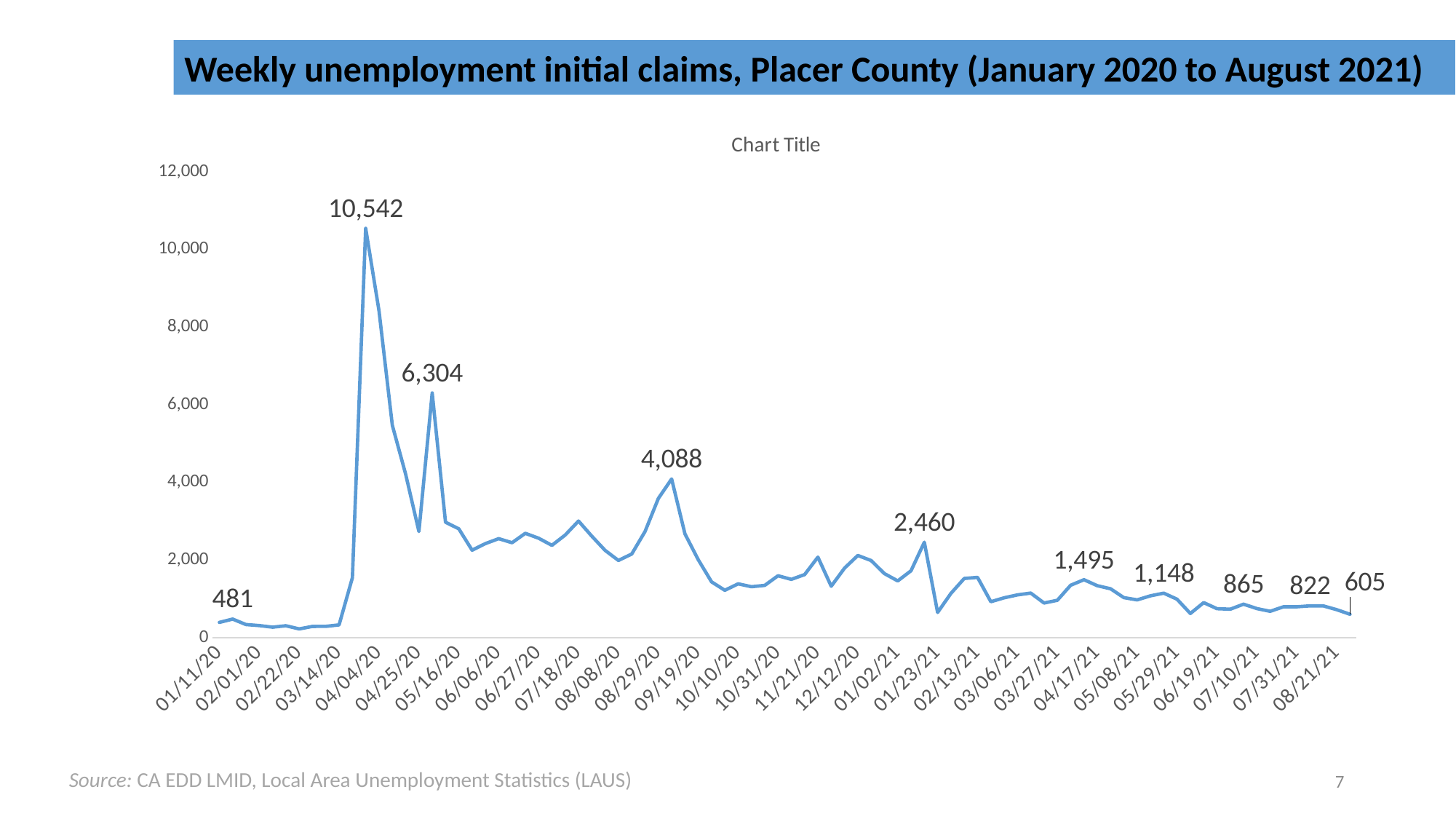
What is the difference between the labeled values 4,088 and 2,460? 1,628 What is the value labeled at the final point of the line, in August 2021? 605 What is the value labeled at the peak around late August / September 2020? 4,088 What is the difference between the 10,542 peak and the 6,304 peak? 4,238 Which labeled value is larger, 1,495 or 1,148? 1,495 What is the highest value labeled on the chart? 10,542 Is the value at 08/21/21 greater or less than 2,000? less What is the value labeled at the second peak in May 2020, after the 10,542 peak? 6,304 What placeholder title text appears above the chart area? Chart Title What kind of chart is shown on the slide? line chart From the peak in April 2020 to August 2021, do the values overall rise or fall? fall How many data points on the line have printed value labels? 10